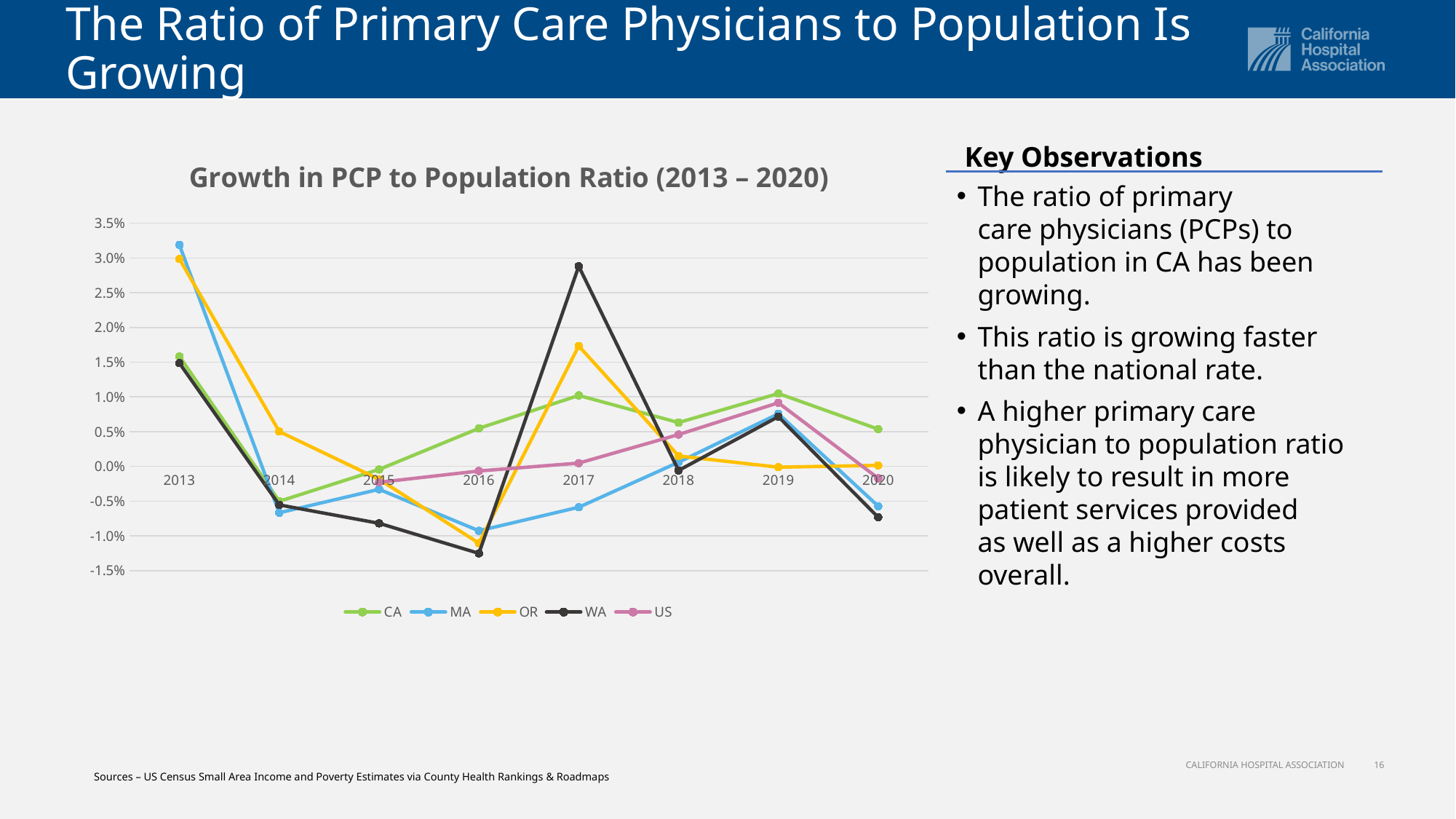
Does the CA line rise or fall from 2013 to 2014? fall Which series has the highest value in 2013? MA Which series has the highest value in 2017? WA What is the title of the chart? Growth in PCP to Population Ratio (2013 – 2020) Which is larger in 2017, the value for CA or the value for MA? CA Is the value for WA in 2017 greater or less than 2.5%? greater What kind of chart is shown on the slide? line chart Is the value for OR in 2016 greater or less than -0.5%? less How many years are shown on the x axis? 8 Which series has the lowest value in 2015? WA How many series does the legend list? 5 Is the value for MA in 2013 greater or less than 2.5%? greater